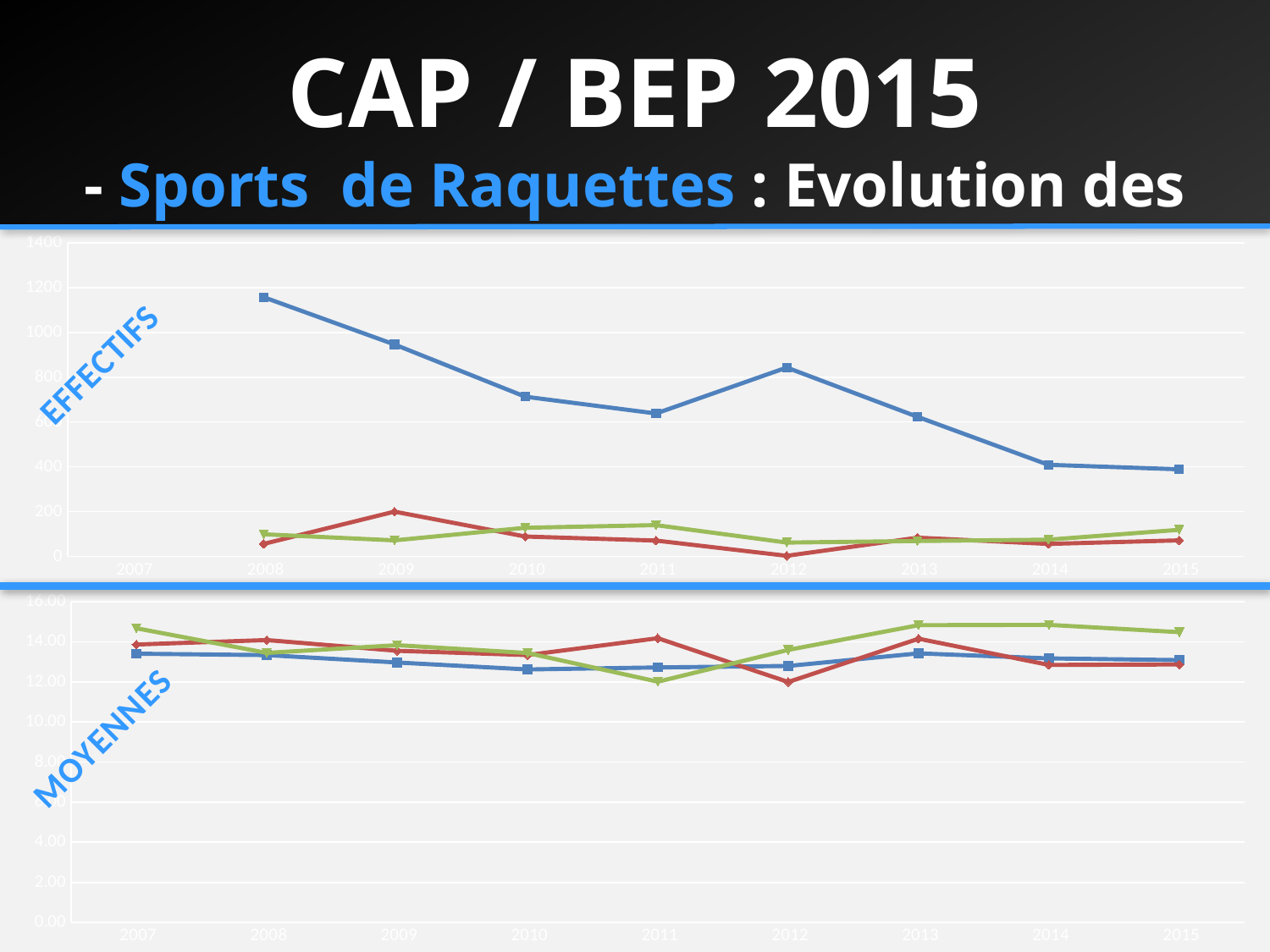
How many years are shown on the x axis of the top chart (EFFECTIFS)? 9 In the bottom chart (MOYENNES), is the value of the green line in 2007 greater or less than 14.00? greater How many lines are plotted on the bottom chart (MOYENNES)? 3 In the bottom chart (MOYENNES), in which year is the green line at its lowest? 2011 In the top chart (EFFECTIFS), which is larger in 2012: the blue line or the red line? the blue line In the top chart (EFFECTIFS), in which year does the red line reach its lowest point? 2012 In the top chart (EFFECTIFS), does the blue line rise or fall overall from 2008 to 2015? fall In the top chart (EFFECTIFS), is the value of the blue line in 2008 greater or less than 1000? greater What kind of chart is the top chart (EFFECTIFS)? line chart What kind of chart is the bottom chart (MOYENNES)? line chart In the top chart (EFFECTIFS), in which year is the blue line at its highest? 2008 In the top chart (EFFECTIFS), is the value of the blue line in 2011 greater or less than 800? less